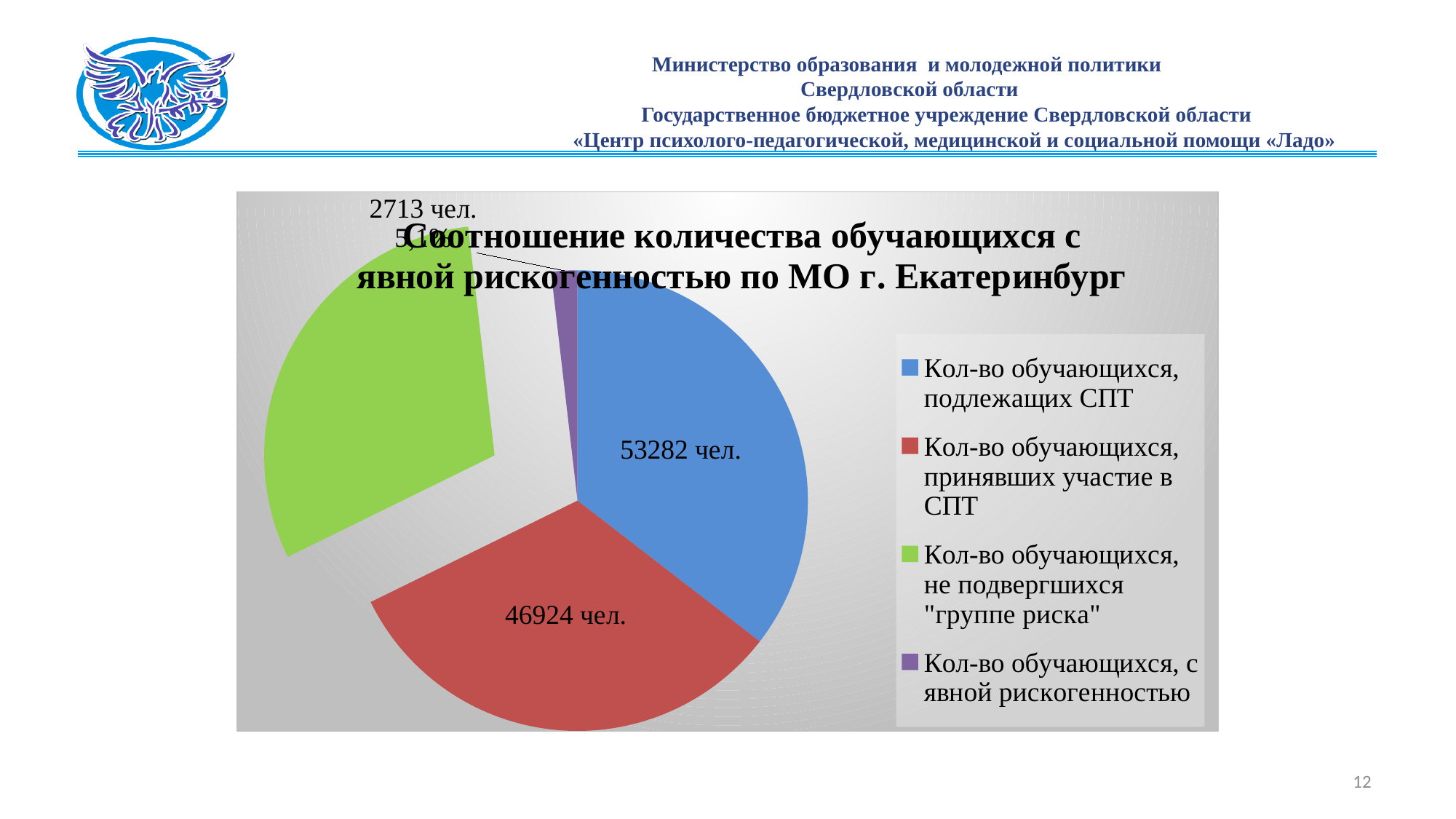
How many slices does the pie chart have? 4 What is the value for "Кол-во обучающихся, подлежащих СПТ"? 53282 чел. What is the value for "Кол-во обучающихся, принявших участие в СПТ"? 46924 чел. What kind of chart is shown on the slide? pie chart Which is larger: the number of students subject to СПТ or the number who took part in СПТ? Кол-во обучающихся, подлежащих СПТ What colour is the slice for "Кол-во обучающихся, с явной рискогенностью"? purple Which category has the smallest slice of the pie? Кол-во обучающихся, с явной рискогенностью Which category has the largest slice of the pie? Кол-во обучающихся, подлежащих СПТ What is the title of the chart? Соотношение количества обучающихся с явной рискогенностью по МО г. Екатеринбург How many entries does the legend list? 4 What is the difference between the number of students subject to СПТ and the number who took part in СПТ? 6358 чел. What is the value for "Кол-во обучающихся, с явной рискогенностью"? 2713 чел.